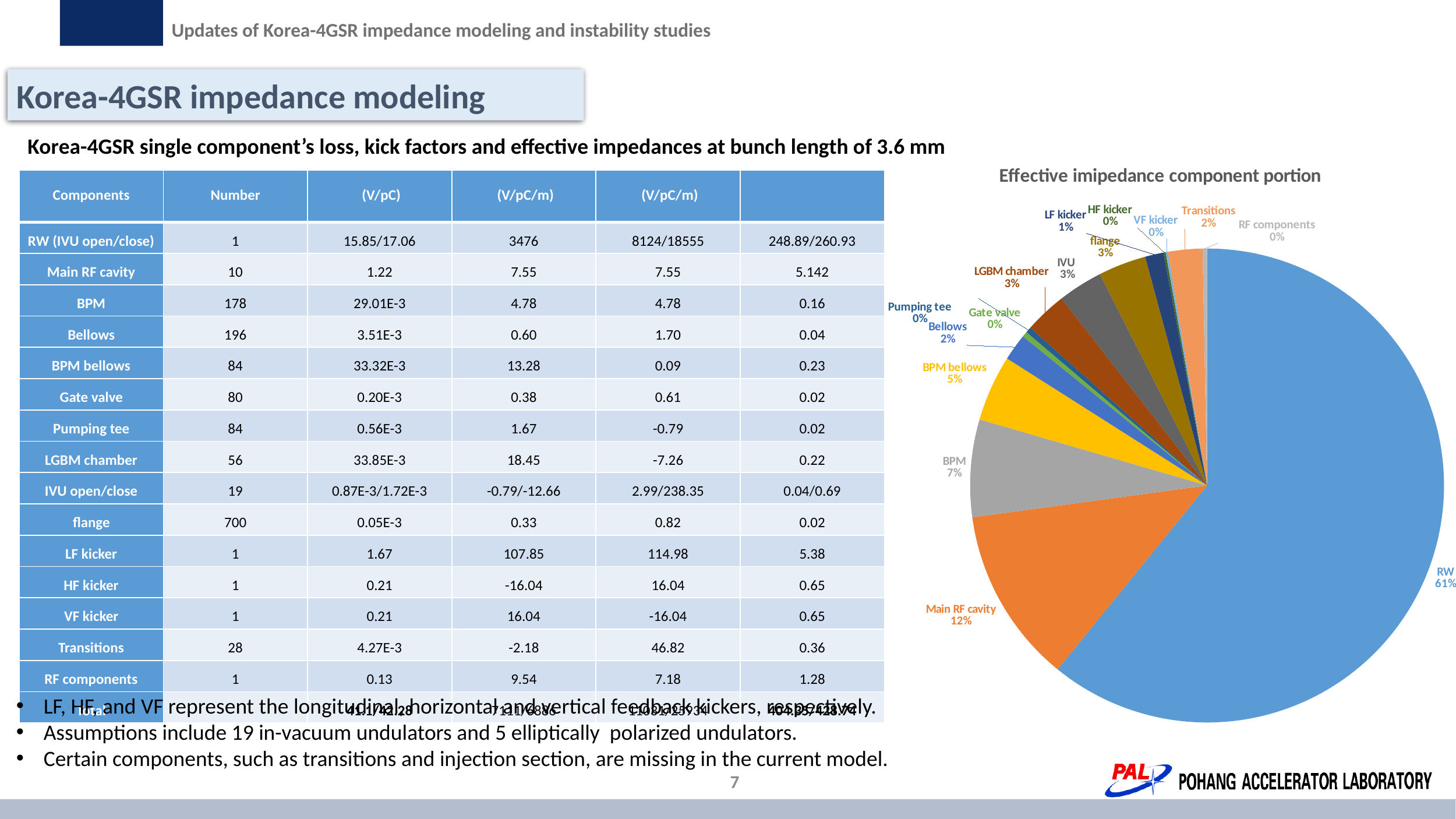
What share of the pie does BPM have? 7% What is the difference in percentage points between the RW slice and the Main RF cavity slice? 49 What share of the pie does LF kicker have? 1% What kind of chart is shown on the slide? pie chart What share of the pie does RW have? 61% What is the title of the pie chart? Effective imipedance component portion Which is larger in the pie chart, Main RF cavity or BPM? Main RF cavity Which component has the largest slice of the pie? RW How many components are labelled in the pie chart? 15